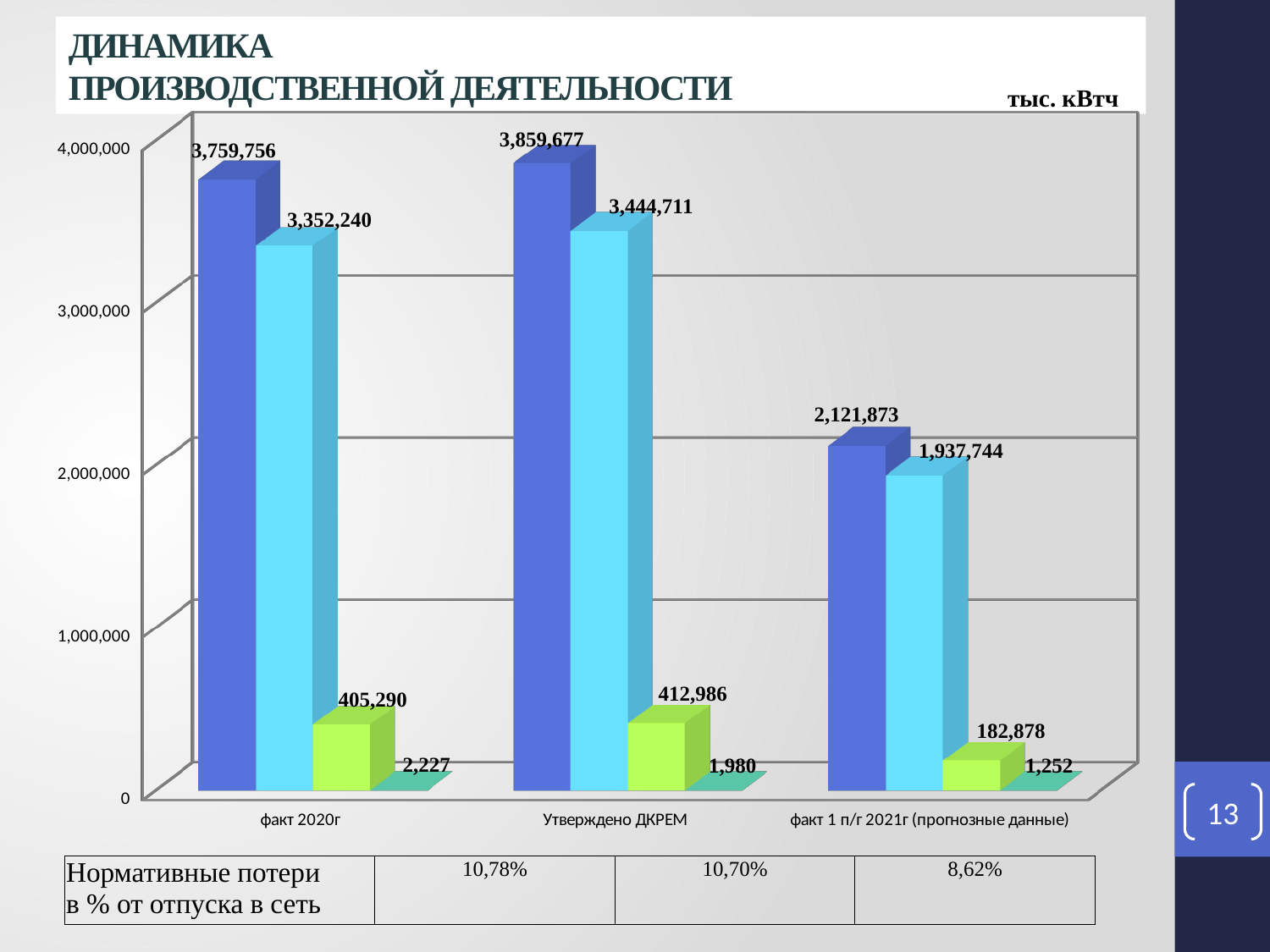
What type of chart is shown on the slide? bar chart What is the value of the dark blue bar for факт 2020г? 3,759,756 Is the light blue bar for факт 2020г greater or less than 3,000,000? greater Which category has the lowest green bar? факт 1 п/г 2021г (прогнозные данные) Which is larger: the light blue bar for факт 2020г or the light blue bar for факт 1 п/г 2021г (прогнозные данные)? факт 2020г What is the value of the green bar for факт 1 п/г 2021г (прогнозные данные)? 182,878 What unit of measurement is indicated above the chart? тыс. кВтч What is the value of the teal bar for Утверждено ДКРЕМ? 1,980 What is the difference between the dark blue bars for Утверждено ДКРЕМ and факт 2020г? 99,921 How many categories are shown on the x axis of the chart? 3 What is the value of the light blue bar for Утверждено ДКРЕМ? 3,444,711 Which category has the highest dark blue bar? Утверждено ДКРЕМ